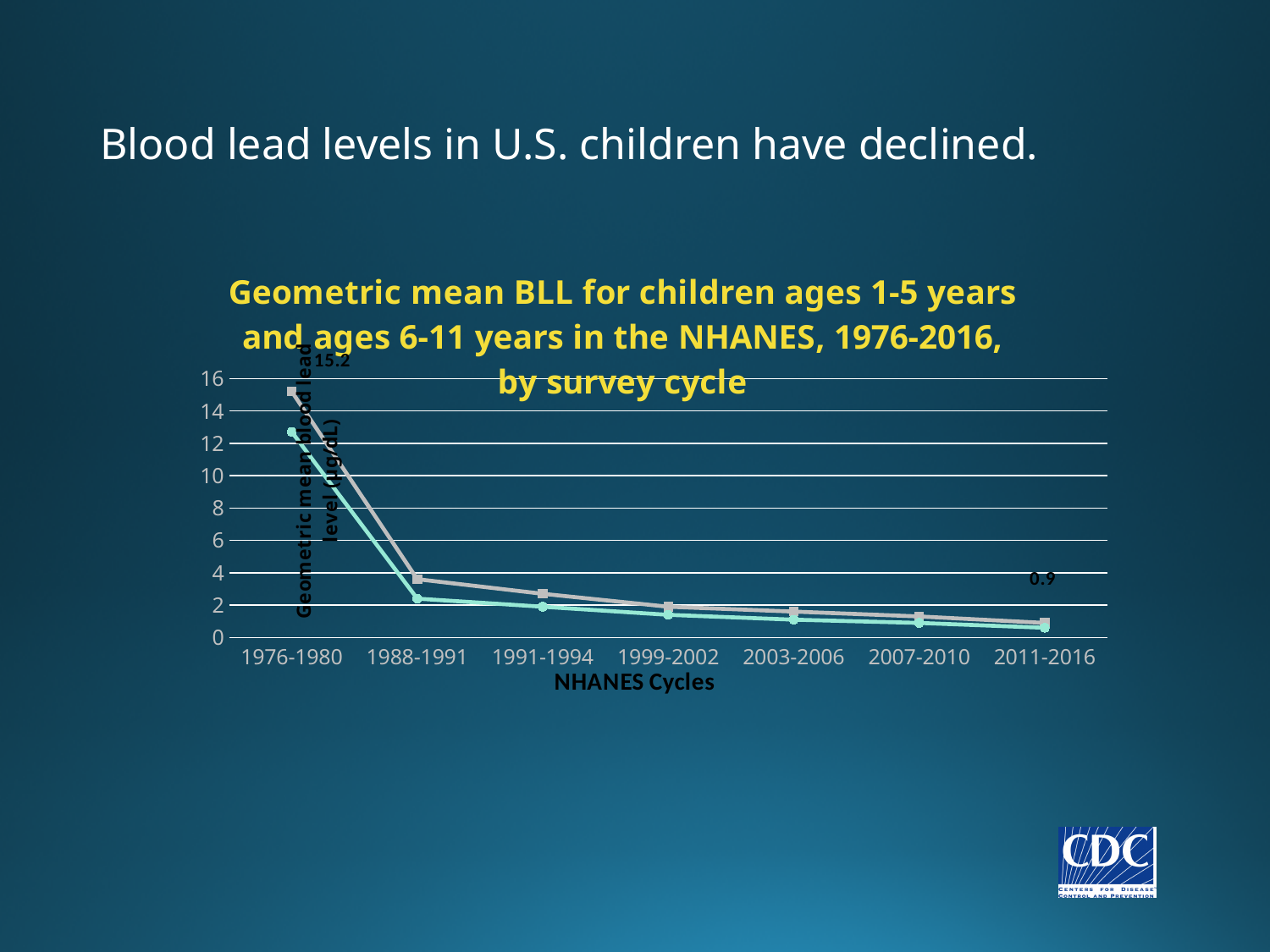
What kind of chart is shown on the slide? line chart For the upper (gray) line, what is the difference between the 1976-1980 value and the 2011-2016 value? 14.3 What is the labeled value of the upper (gray) line for the 1976-1980 cycle? 15.2 How many lines are plotted on the chart? 2 What is the label on the x axis of the chart? NHANES Cycles How many NHANES survey cycles are shown on the x axis? 7 Which survey cycle has the lowest geometric mean blood lead level? 2011-2016 Is the value of the lower (teal) line for 1976-1980 greater or less than 10? greater Do the blood lead levels rise or fall across the survey cycles from 1976-1980 to 2011-2016? fall What is the labeled value of the upper (gray) line for the 2011-2016 cycle? 0.9 Is the value of the upper (gray) line for 1988-1991 greater or less than 6? less Which survey cycle has the highest geometric mean blood lead level? 1976-1980